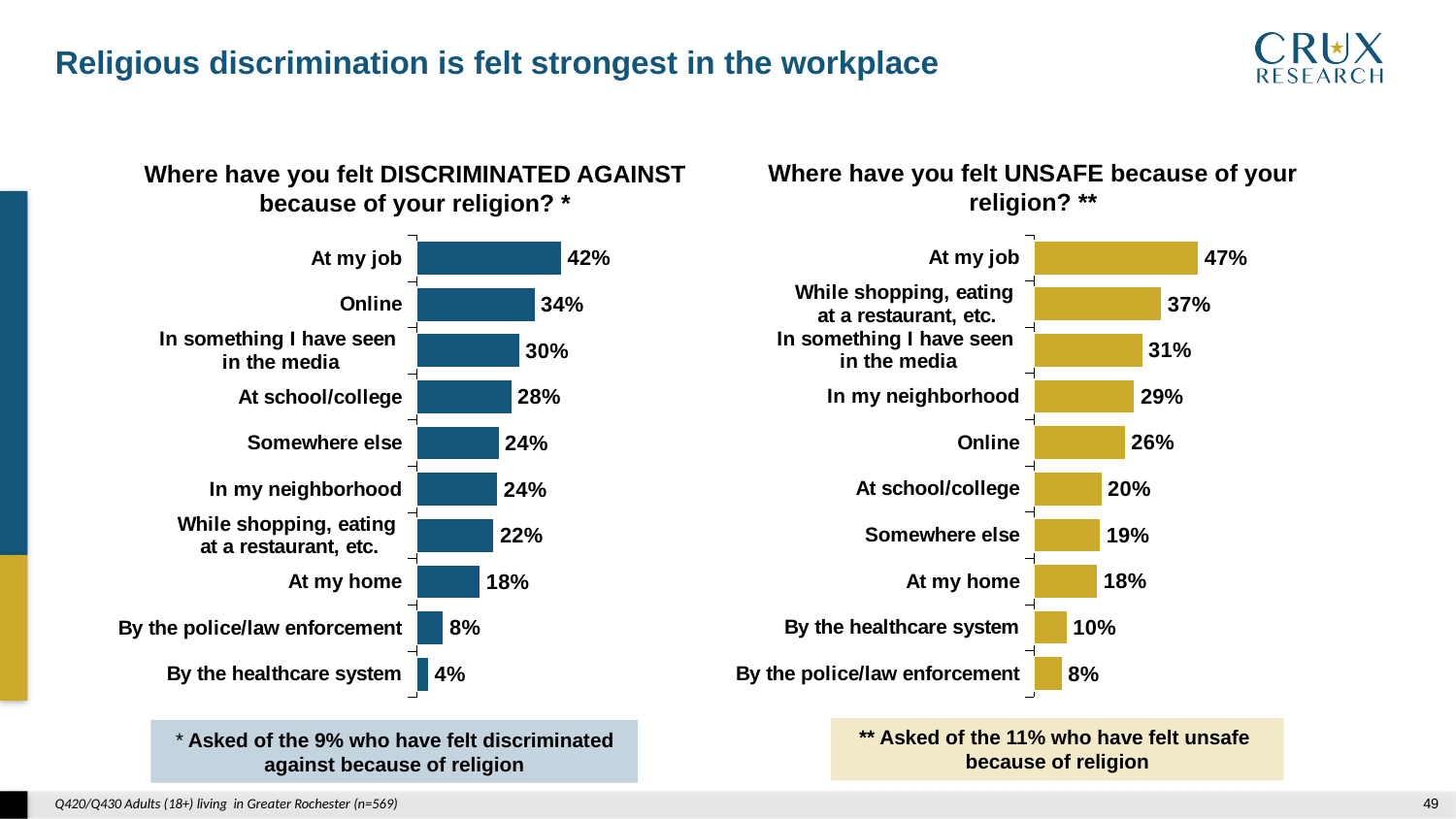
In the 'Where have you felt UNSAFE because of your religion?' chart, what is the value for 'At my home'? 18% In the 'Where have you felt UNSAFE because of your religion?' chart, what is the value for 'In my neighborhood'? 29% In the 'Where have you felt UNSAFE because of your religion?' chart, what is the difference between 'At my job' and 'While shopping, eating at a restaurant, etc.'? 10% In the 'Where have you felt DISCRIMINATED AGAINST because of your religion?' chart, what is the difference between 'At my job' and 'By the healthcare system'? 38% What type of chart is the 'Where have you felt UNSAFE because of your religion?' chart? Bar chart In the 'Where have you felt DISCRIMINATED AGAINST because of your religion?' chart, how many categories are shown? 10 In the 'Where have you felt DISCRIMINATED AGAINST because of your religion?' chart, which category has the highest value? At my job In the 'Where have you felt UNSAFE because of your religion?' chart, which is larger: 'Online' or 'At school/college'? Online What colour are the bars in the 'Where have you felt UNSAFE because of your religion?' chart? Gold/yellow In the 'Where have you felt DISCRIMINATED AGAINST because of your religion?' chart, what is the value for 'Online'? 34% In the 'Where have you felt UNSAFE because of your religion?' chart, which category has the lowest value? By the police/law enforcement In the 'Where have you felt DISCRIMINATED AGAINST because of your religion?' chart, what is the value for 'By the police/law enforcement'? 8%